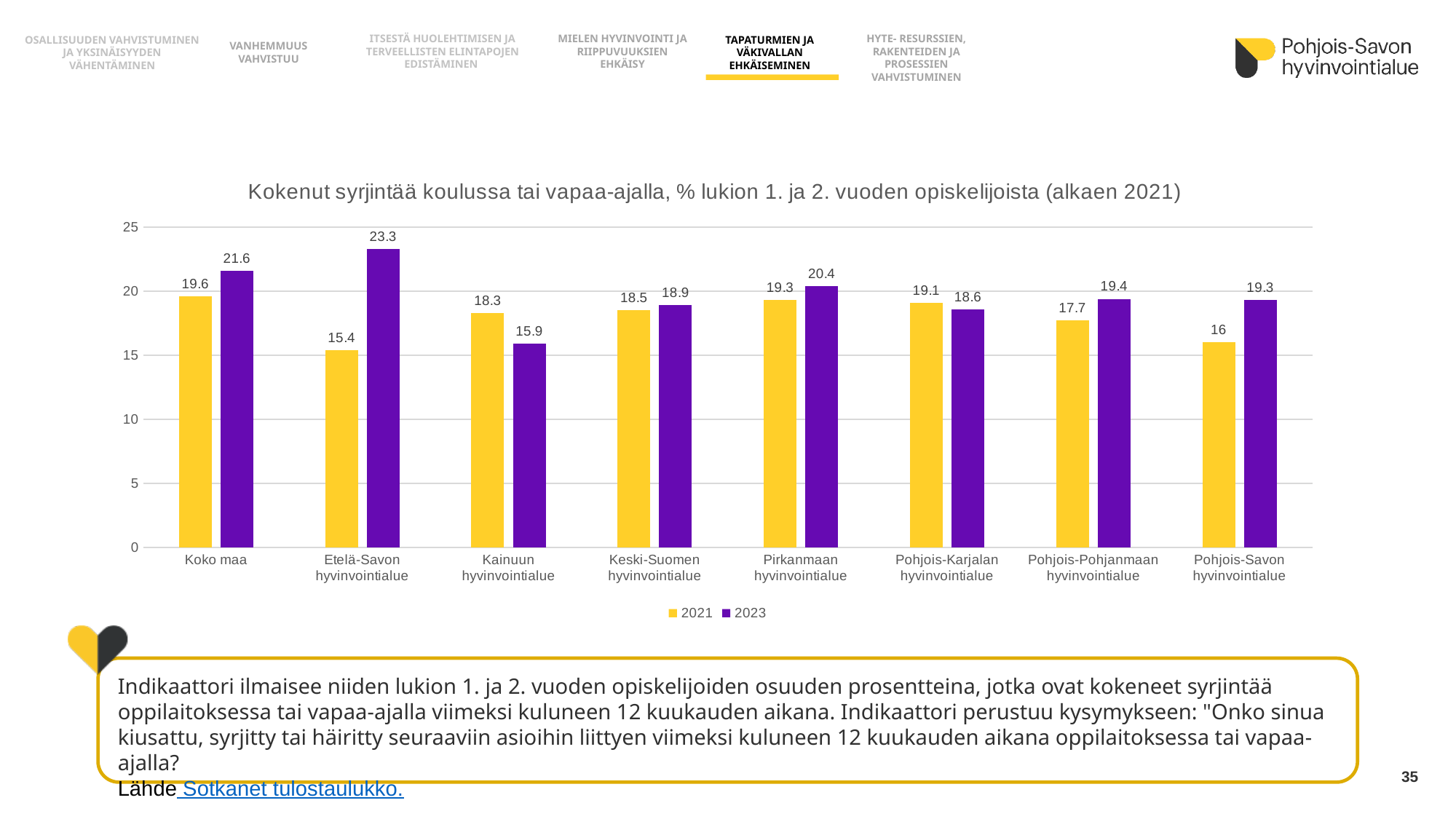
What is the 2021 value for Pohjois-Savon hyvinvointialue? 16 Which category has the lowest 2021 value? Etelä-Savon hyvinvointialue Is the 2023 value for Etelä-Savon hyvinvointialue greater or less than 20? greater Which category has the highest 2023 value? Etelä-Savon hyvinvointialue Which is larger for Kainuun hyvinvointialue, the 2021 value or the 2023 value? 2021 Which colour represents the 2023 series? Purple What is the 2021 value for Koko maa? 19.6 What kind of chart is shown on the slide? Bar chart What is the difference between the 2023 and 2021 values for Pohjois-Savon hyvinvointialue? 3.3 What is the 2023 value for Etelä-Savon hyvinvointialue? 23.3 How many series does the legend list? 2 How many categories are shown on the x axis? 8